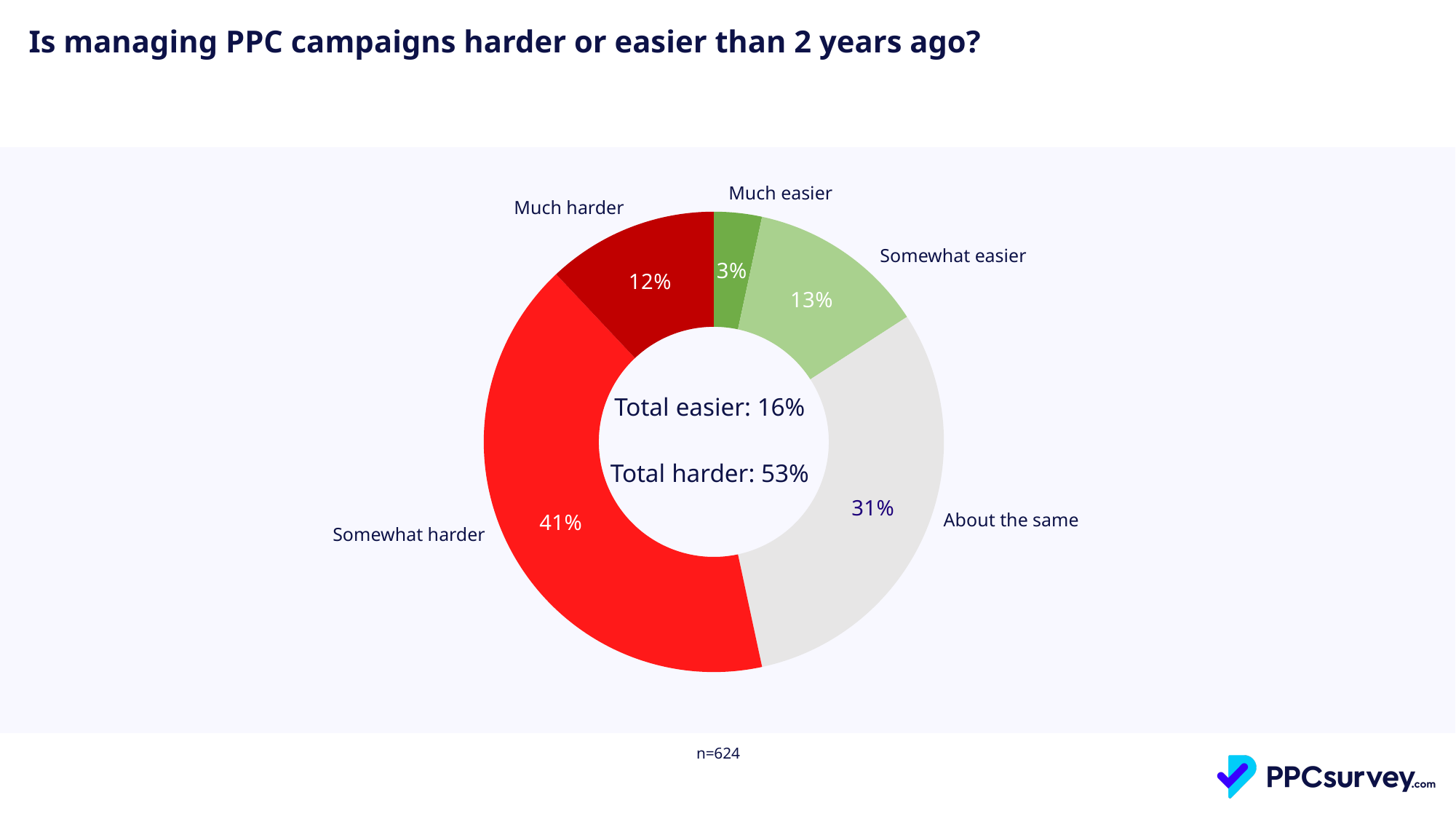
What is the total share of respondents who said managing PPC campaigns is harder? 53% What percentage of respondents said managing PPC campaigns is much harder? 12% What percentage of respondents said managing PPC campaigns is about the same? 31% Which response category has the smallest share? Much easier What is the difference in percentage points between 'Somewhat harder' and 'About the same'? 10 How many response categories are shown in the chart? 5 What percentage of respondents said managing PPC campaigns is much easier? 3% What kind of chart is shown on the slide? Pie chart (donut) What is the sample size (n) shown on the slide? n=624 Which response category has the largest share? Somewhat harder Which is larger, the share for 'Somewhat easier' or the share for 'Much harder'? Somewhat easier What percentage of respondents said managing PPC campaigns is somewhat harder? 41%